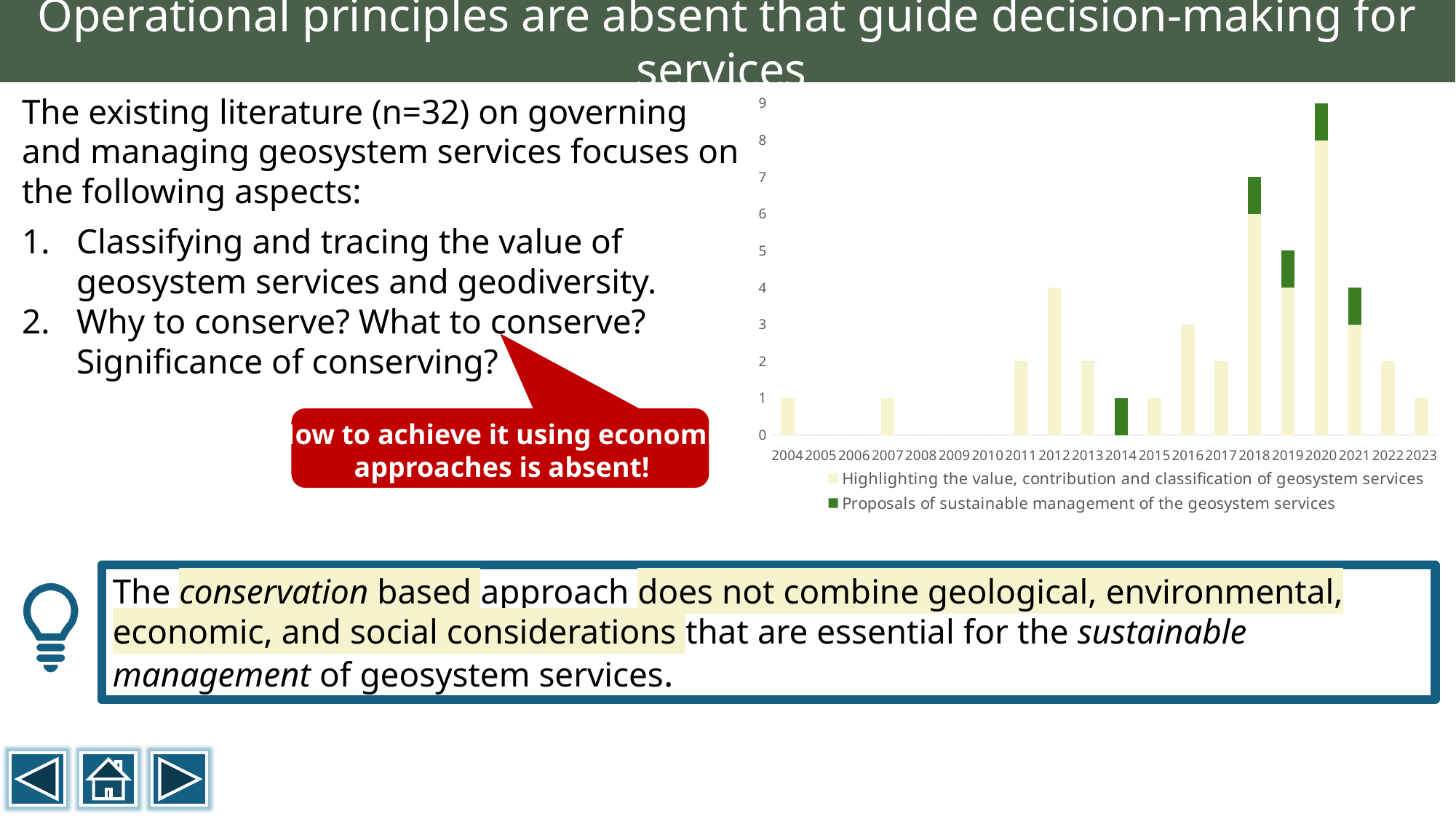
What is the value for 'Proposals of sustainable management of the geosystem services' in 2014? 1 Is the total value for 2020 greater or less than 8? greater Which is larger, the bar for 2012 or the bar for 2016? 2012 What is the difference between the total bar heights for 2020 and 2018? 2 What is the total height of the stacked bar for 2018? 7 What kind of chart is shown on the slide? Stacked bar chart How many series does the chart legend list? 2 Which year has the tallest bar in the chart? 2020 What is the value for 'Highlighting the value, contribution and classification of geosystem services' in 2012? 4 What is the total height of the stacked bar for 2020? 9 Which legend entry is shown in dark green? Proposals of sustainable management of the geosystem services How many years are shown on the x axis of the chart? 20